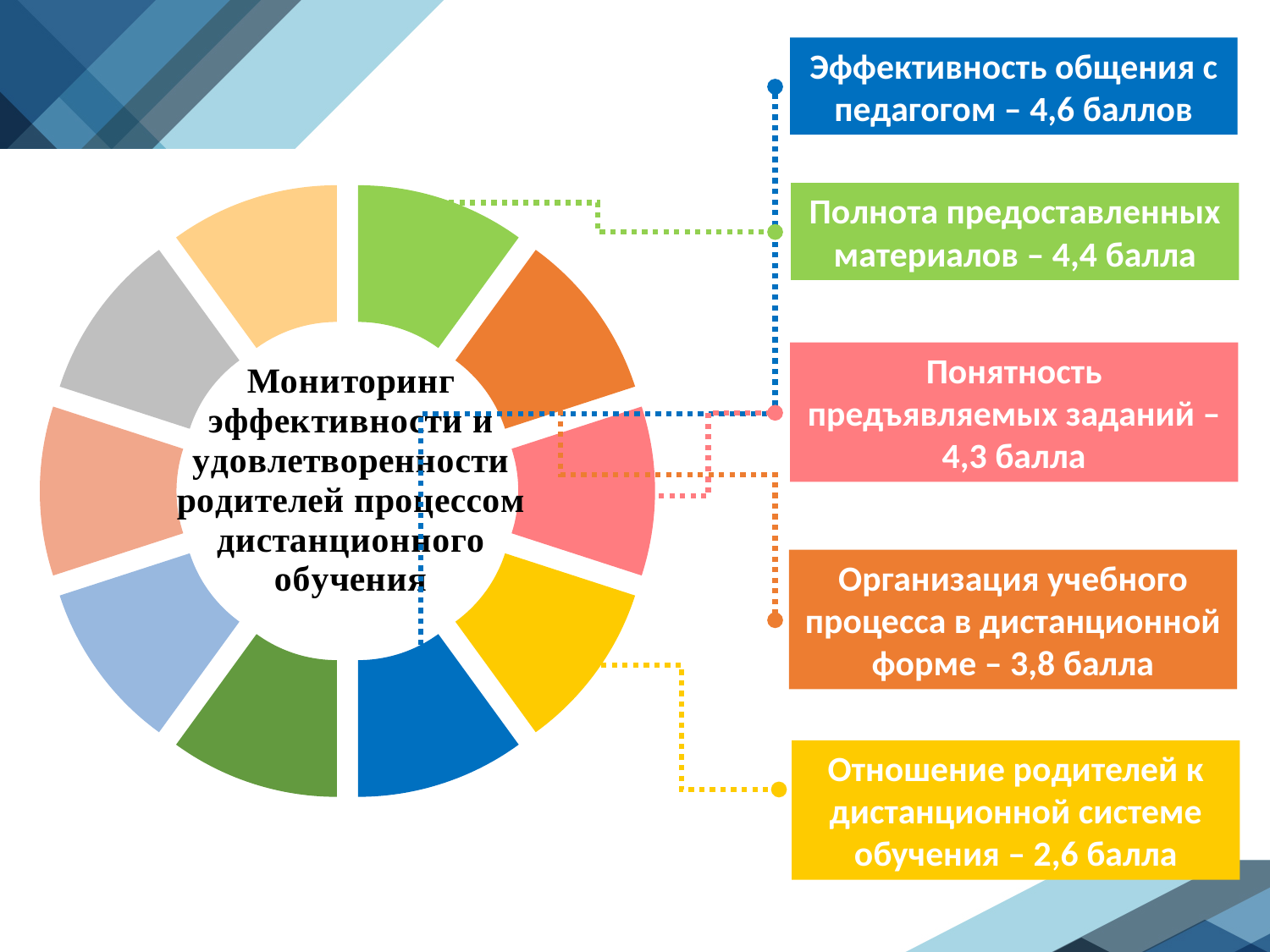
Which has a higher score: «Полнота предоставленных материалов» or «Организация учебного процесса в дистанционной форме»? Полнота предоставленных материалов How many indicators with scores are listed in the boxes on the right of the slide? 5 Which indicator has the highest score? Эффективность общения с педагогом What is the difference between the score for «Эффективность общения с педагогом» and the score for «Отношение родителей к дистанционной системе обучения»? 2,0 балла Which indicator has the lowest score? Отношение родителей к дистанционной системе обучения What score is given for «Эффективность общения с педагогом»? 4,6 баллов What score is given for «Понятность предъявляемых заданий»? 4,3 балла What score is given for «Отношение родителей к дистанционной системе обучения»? 2,6 балла What score is given for «Организация учебного процесса в дистанционной форме»? 3,8 балла What colour is the box for «Отношение родителей к дистанционной системе обучения»? Yellow What score is given for «Полнота предоставленных материалов»? 4,4 балла What is the title shown in the centre of the ring diagram? Мониторинг эффективности и удовлетворенности родителей процессом дистанционного обучения